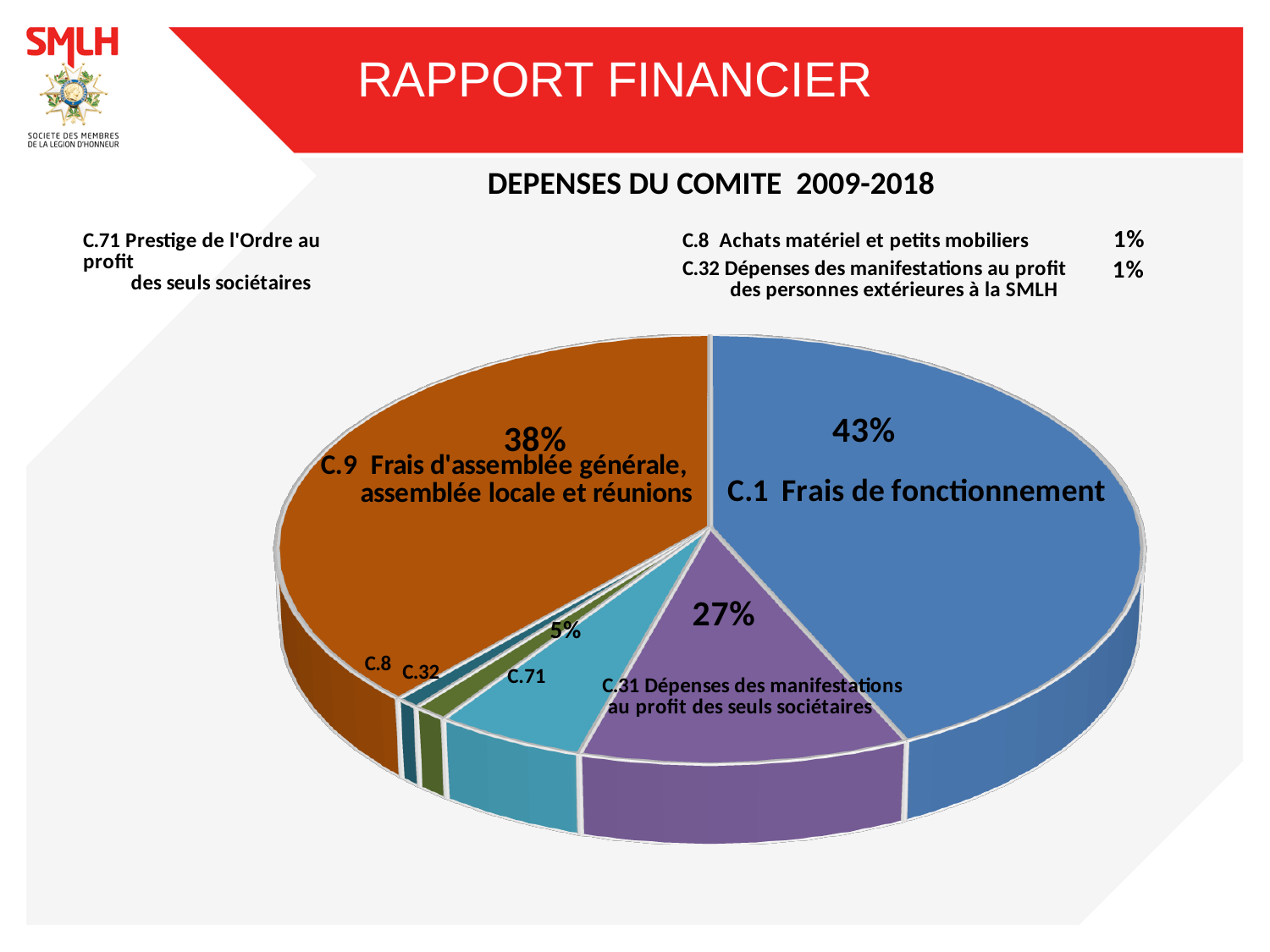
How many slices does the pie chart have? 6 What is the title of the chart? DEPENSES DU COMITE 2009-2018 What kind of chart is shown on the slide? pie chart What is the difference in percentage points between C.1 Frais de fonctionnement and C.9 Frais d'assemblée générale, assemblée locale et réunions? 5 Which is larger, the share for C.9 or the share for C.31? C.9 What percentage is shown for C.9 Frais d'assemblée générale, assemblée locale et réunions? 38% What percentage is shown for C.32 Dépenses des manifestations au profit des personnes extérieures à la SMLH? 1% What percentage is shown for C.8 Achats matériel et petits mobiliers? 1% What percentage is shown for C.71 Prestige de l'Ordre au profit des seuls sociétaires? 5% What percentage is shown for C.1 Frais de fonctionnement? 43% Which category has the largest share of the pie? C.1 Frais de fonctionnement What percentage is shown for C.31 Dépenses des manifestations au profit des seuls sociétaires? 27%